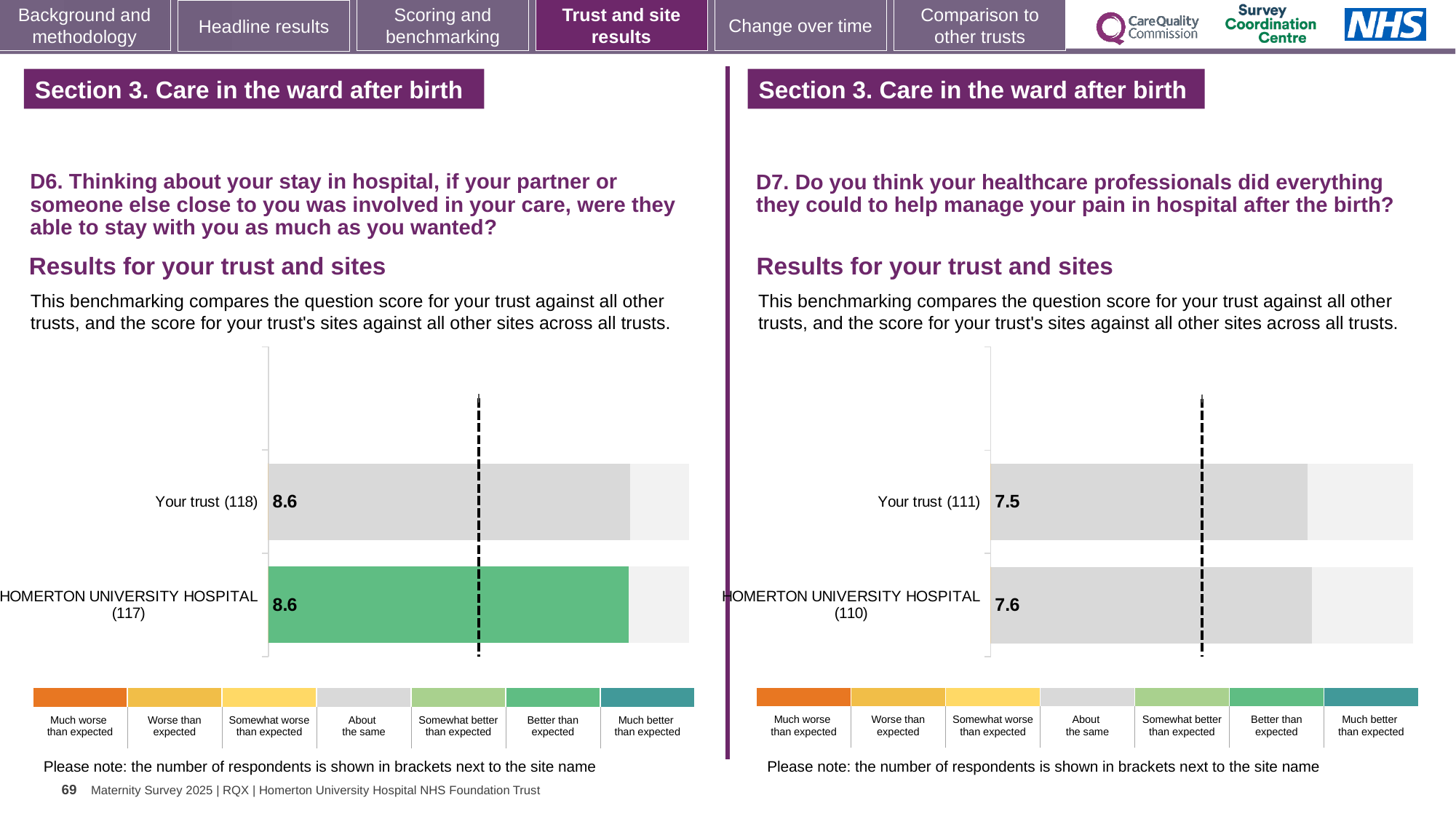
In the D6 chart on the left, how many bars are plotted? 2 In the D6 chart on the left, what is the score for Your trust? 8.6 In the D6 chart on the left, how many respondents are shown in brackets for Your trust? 118 In the D7 chart on the right, which has the higher score, Your trust or Homerton University Hospital? Homerton University Hospital In the D7 chart on the right, is the score for Your trust greater or less than 8? less In the D7 chart on the right, what is the score for Your trust? 7.5 In the D6 chart on the left, what is the score for Homerton University Hospital? 8.6 What type of chart is used in the D7 chart on the right? Bar chart In the D7 chart on the right, what is the score for Homerton University Hospital? 7.6 In the D6 chart on the left, is the score for Your trust greater or less than 8? greater In the D7 chart on the right, how many respondents are shown in brackets for Homerton University Hospital? 110 In the D7 chart on the right, what is the difference between the Homerton University Hospital score and the Your trust score? 0.1